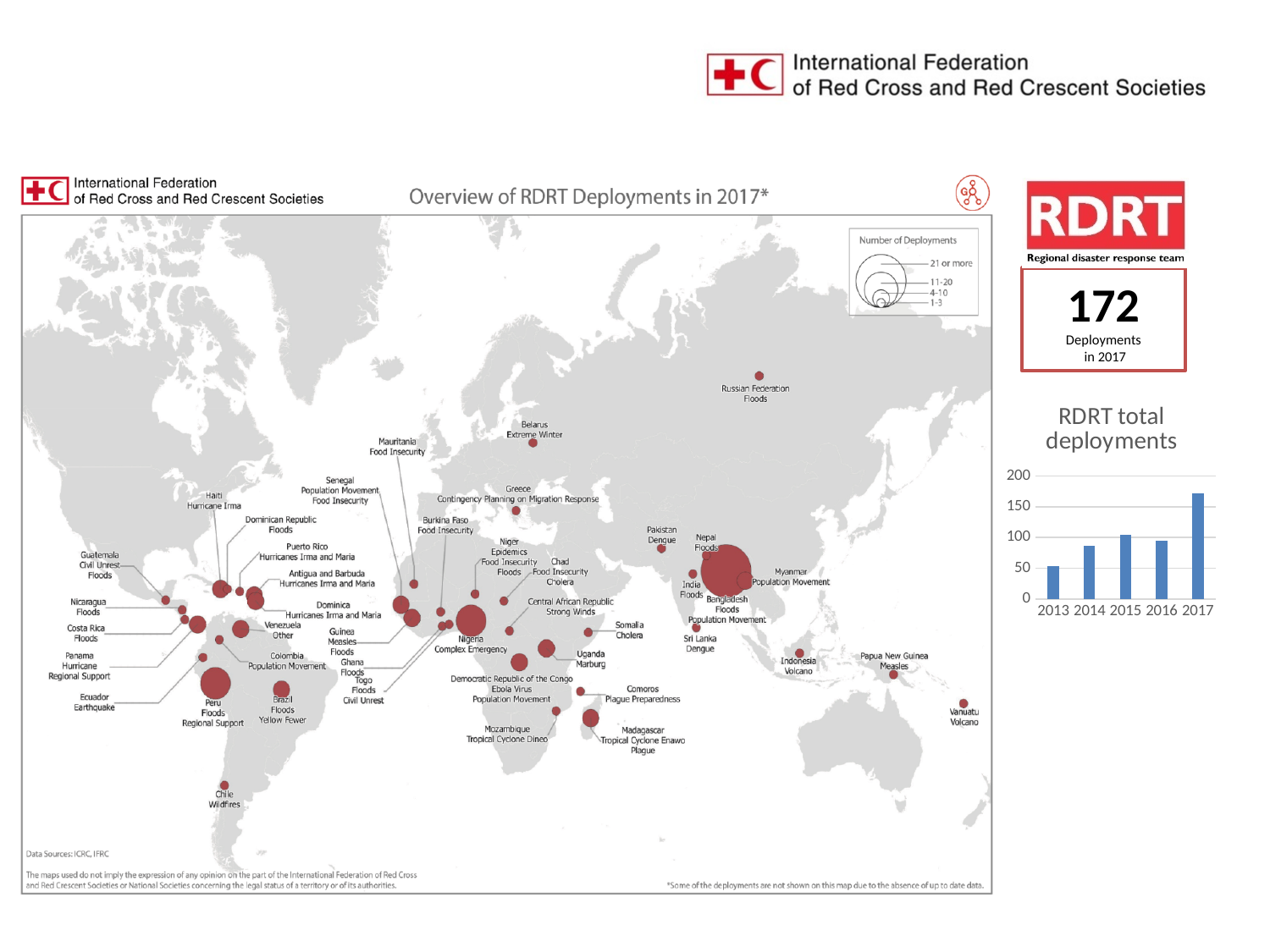
In the 'RDRT total deployments' chart, which year has the highest value? 2017 What kind of chart is the 'RDRT total deployments' chart? bar chart In the 'RDRT total deployments' chart, do the values rise or fall from 2013 to 2015? rise According to the slide, how many RDRT deployments were there in 2017? 172 In the 'RDRT total deployments' chart, is the value for 2017 greater or less than 150? greater In the 'RDRT total deployments' chart, which year has the lowest value? 2013 In the 'RDRT total deployments' chart, is the value for 2014 greater or less than 50? greater In the 'RDRT total deployments' chart, is the value for 2013 greater or less than 100? less In the 'RDRT total deployments' chart, which year has the larger value, 2013 or 2015? 2015 How many years are shown on the x axis of the 'RDRT total deployments' chart? 5 What is the highest tick value shown on the y axis of the 'RDRT total deployments' chart? 200 In the 'RDRT total deployments' chart, which year has the larger value, 2016 or 2017? 2017